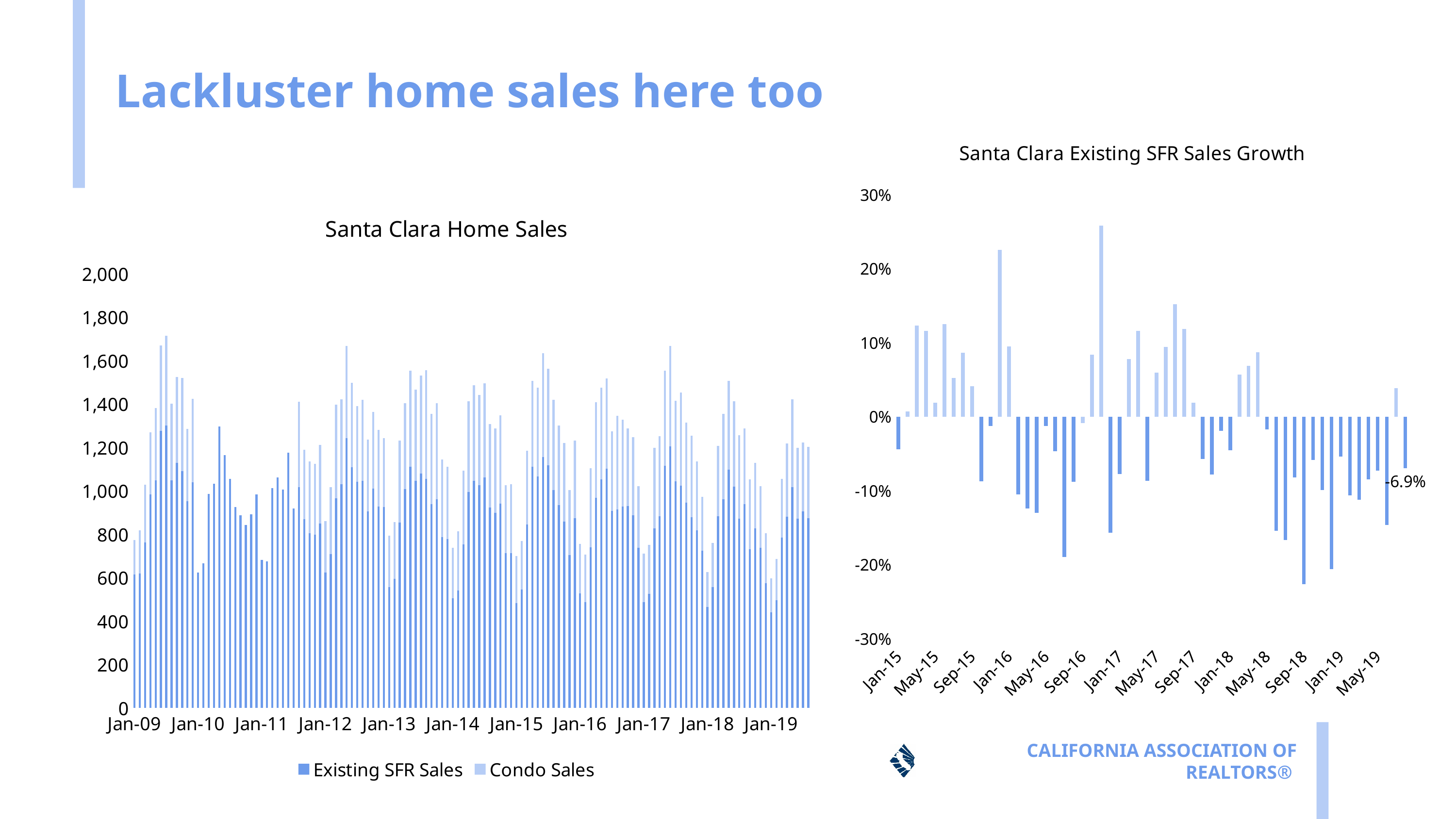
On the "Santa Clara Existing SFR Sales Growth" chart, are the growth values in 2019 mostly positive or mostly negative? mostly negative What kind of chart is the "Santa Clara Existing SFR Sales Growth" chart on the right? bar chart How many year labels (Jan-09 through Jan-19) are shown on the x axis of the "Santa Clara Home Sales" chart? 11 What kind of chart is the "Santa Clara Home Sales" chart on the left? bar chart On the "Santa Clara Existing SFR Sales Growth" chart, is the value for Jan-15 greater or less than 0%? less What is the title of the chart on the right side of the slide? Santa Clara Existing SFR Sales Growth On the "Santa Clara Existing SFR Sales Growth" chart, what value is printed as the data label on the most recent bar? -6.9% How many series does the legend of the "Santa Clara Home Sales" chart list? 2 What are the two series named in the legend of the "Santa Clara Home Sales" chart? Existing SFR Sales and Condo Sales On the "Santa Clara Home Sales" chart, is the total stacked value for Jan-09 greater or less than 1,000? less On the "Santa Clara Home Sales" chart, which series is larger in Jan-09, Existing SFR Sales or Condo Sales? Existing SFR Sales On the "Santa Clara Existing SFR Sales Growth" chart, is the labeled most recent value greater or less than -10%? greater